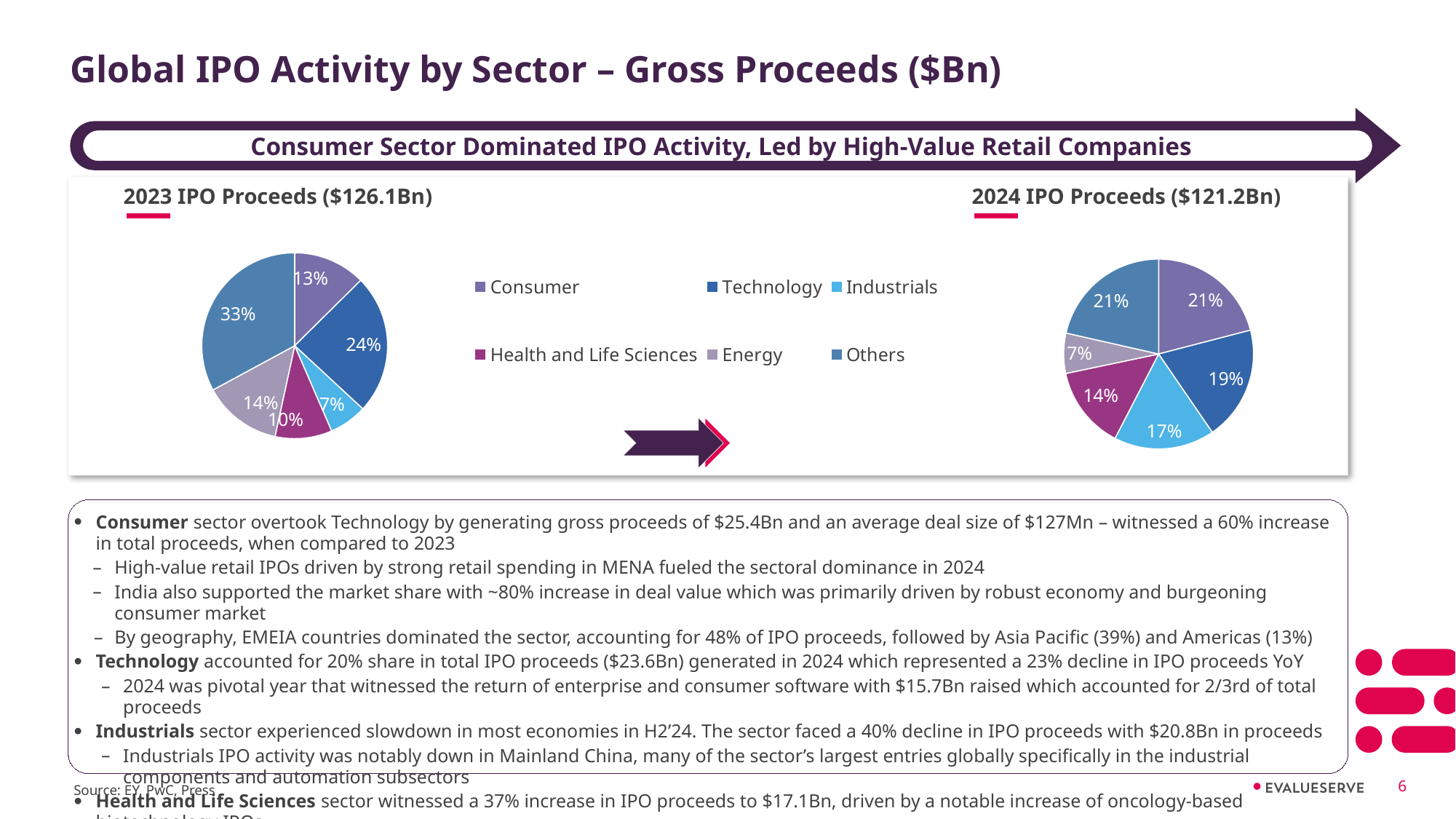
In the 2023 IPO Proceeds pie chart, what is the difference between the Others share and the Consumer share? 20 percentage points In the 2023 IPO Proceeds pie chart, which sector has the smallest share? Industrials How many percentage points did the Consumer share grow from the 2023 pie chart to the 2024 pie chart? 8 In the 2024 IPO Proceeds pie chart, what share does Industrials hold? 17% In the 2024 IPO Proceeds pie chart, which is larger: the Technology share or the Health and Life Sciences share? Technology In the 2023 IPO Proceeds pie chart, which sector has the largest share? Others What type of chart is used to show the 2023 and 2024 IPO proceeds by sector? Pie chart In the 2024 IPO Proceeds pie chart, which sector has the smallest share? Energy How many sectors does the legend list for the pie charts? 6 In the 2023 IPO Proceeds pie chart, what share does Technology hold? 24% What total value is shown in the title of the 2024 IPO Proceeds pie chart? $121.2Bn In the 2024 IPO Proceeds pie chart, what share does Health and Life Sciences hold? 14%